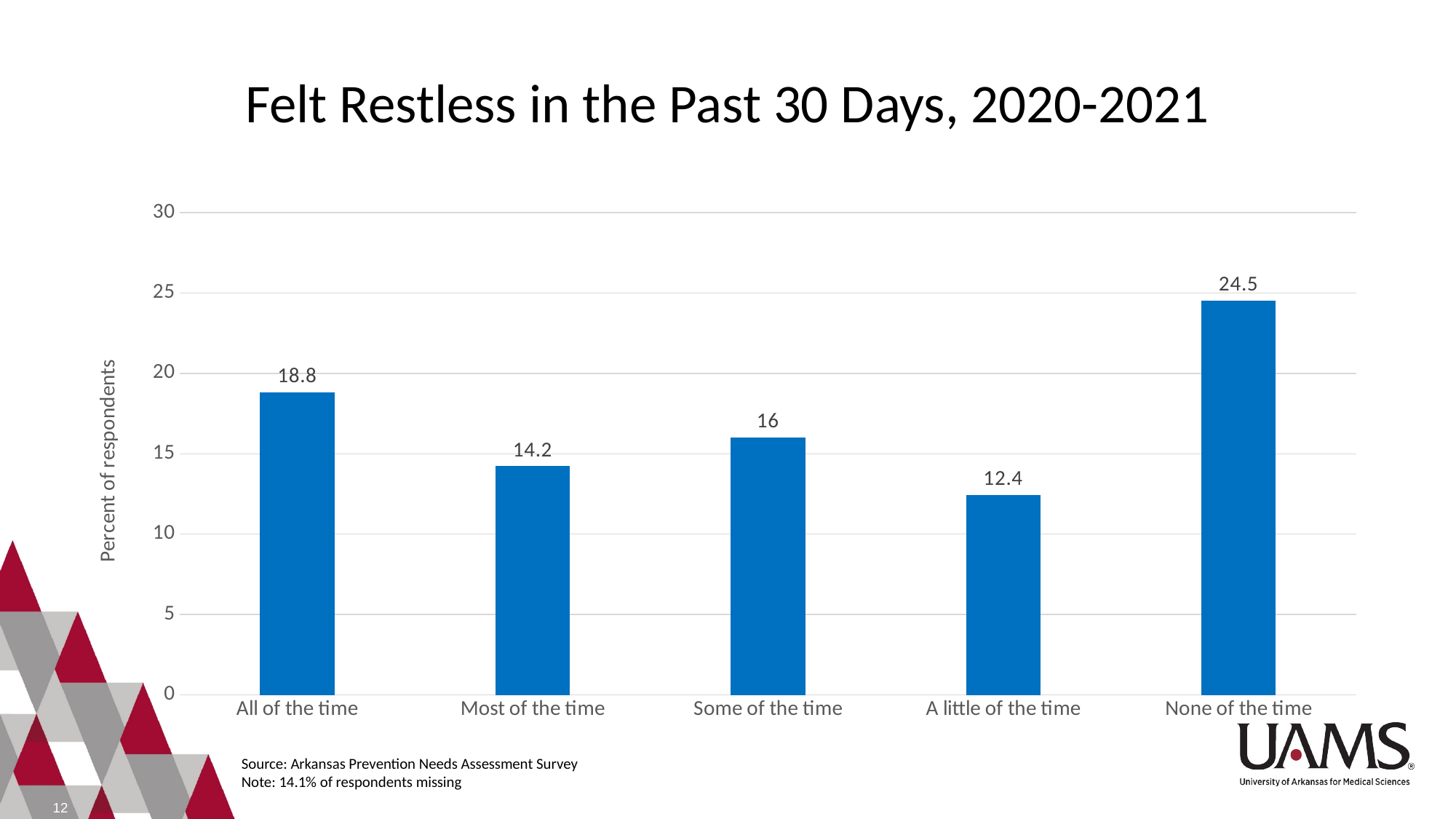
What is the value for "None of the time"? 24.5 What is the value for "All of the time"? 18.8 Which is larger, the value for "Some of the time" or the value for "Most of the time"? Some of the time Is the value for "Most of the time" greater or less than 15? less What is the difference between the values for "None of the time" and "All of the time"? 5.7 Which category has the highest value? None of the time What is the difference between the values for "Some of the time" and "Most of the time"? 1.8 How many categories are shown on the x axis? 5 What is the value for "A little of the time"? 12.4 What kind of chart is shown on the slide? bar chart What is the title of the chart? Felt Restless in the Past 30 Days, 2020-2021 Which category has the lowest value? A little of the time